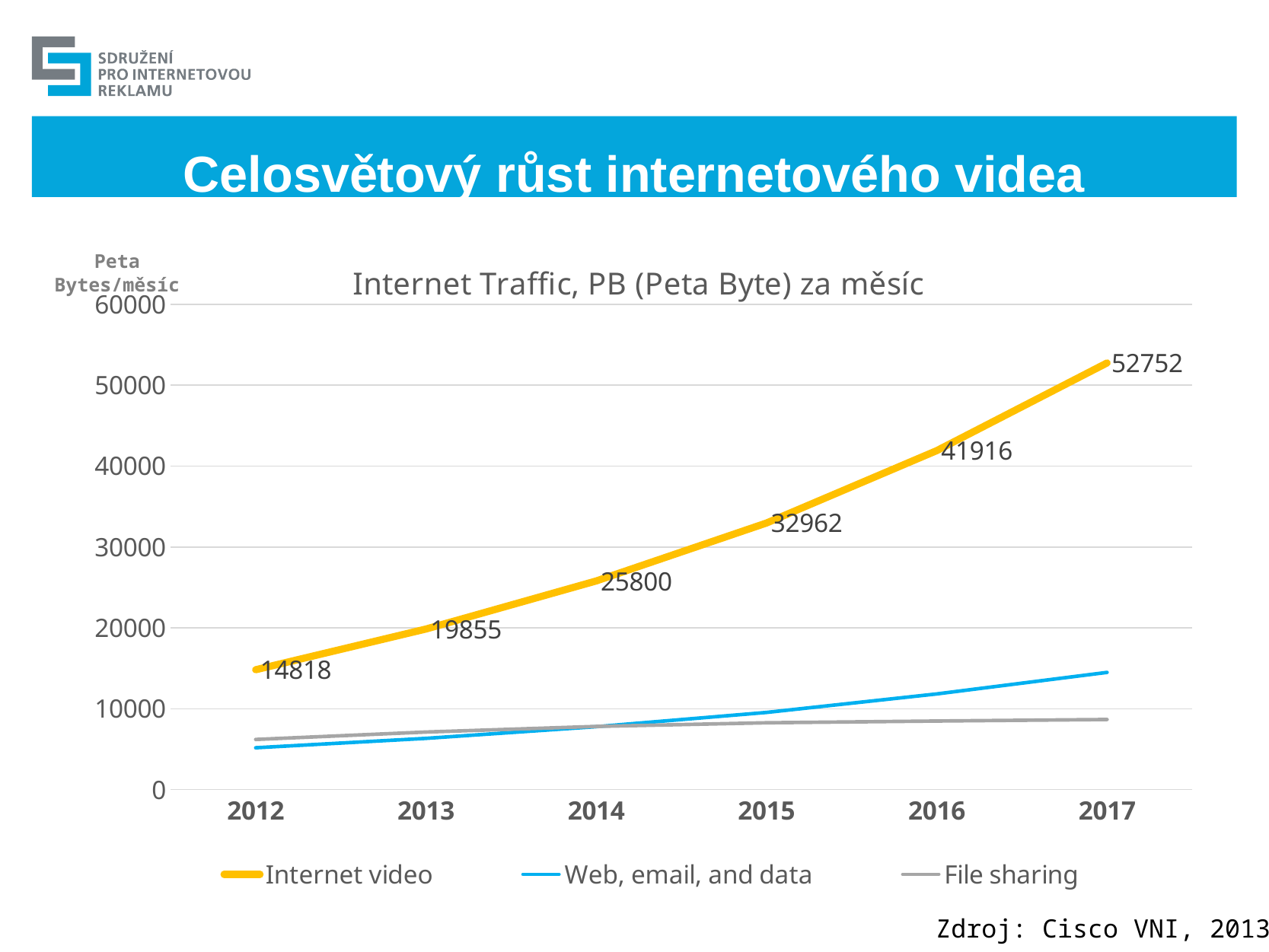
What is the value for Internet video in 2015? 32962 In which year is the Internet video value highest? 2017 What kind of chart is shown on the slide? line chart Which series has the larger value in 2017, Internet video or File sharing? Internet video Is the value for File sharing in 2012 greater or less than 10000? less In which year is the Internet video value lowest? 2012 How many years are shown on the x axis? 6 What is the value for Internet video in 2017? 52752 Is the value for Web, email, and data in 2017 greater or less than 20000? less How many series does the legend list? 3 What is the difference between the Internet video values for 2017 and 2016? 10836 What is the value for Internet video in 2012? 14818